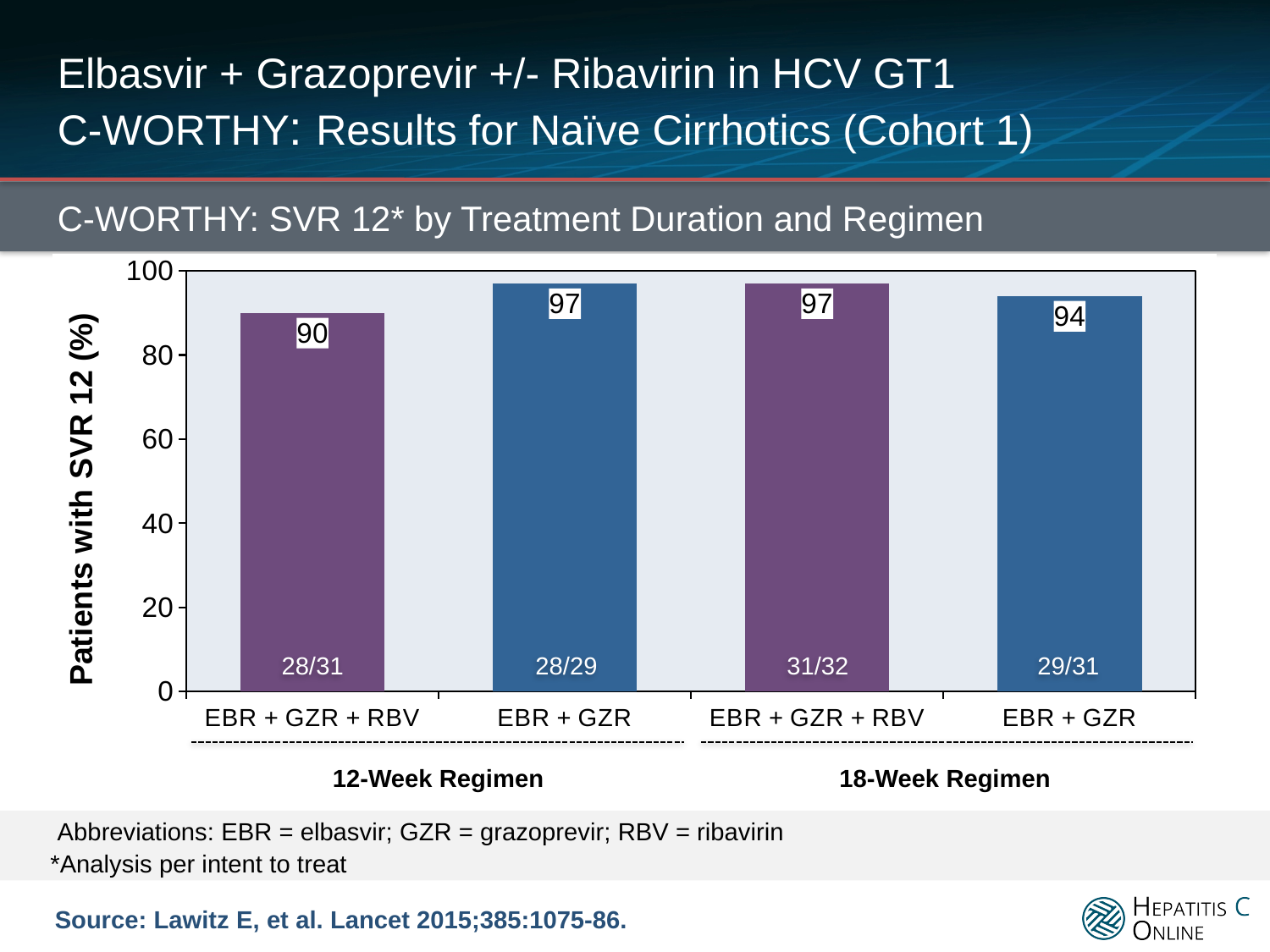
What is the difference in SVR 12 rate between EBR + GZR and EBR + GZR + RBV in the 12-Week Regimen? 7 What is the SVR 12 rate for EBR + GZR in the 12-Week Regimen? 97 What is the label of the y axis? Patients with SVR 12 (%) What is the title of the chart? C-WORTHY: SVR 12* by Treatment Duration and Regimen What is the SVR 12 rate for EBR + GZR in the 18-Week Regimen? 94 What fraction of patients is shown inside the bar for EBR + GZR + RBV in the 18-Week Regimen? 31/32 What kind of chart is shown on the slide? Bar chart Which has a higher SVR 12 rate: EBR + GZR + RBV in the 18-Week Regimen or EBR + GZR in the 18-Week Regimen? EBR + GZR + RBV How many bars are plotted in the chart? 4 Which bar has the lowest SVR 12 rate? EBR + GZR + RBV (12-Week Regimen) What is the SVR 12 rate for EBR + GZR + RBV in the 12-Week Regimen? 90 Is the SVR 12 rate for EBR + GZR + RBV in the 12-Week Regimen greater or less than 80? greater